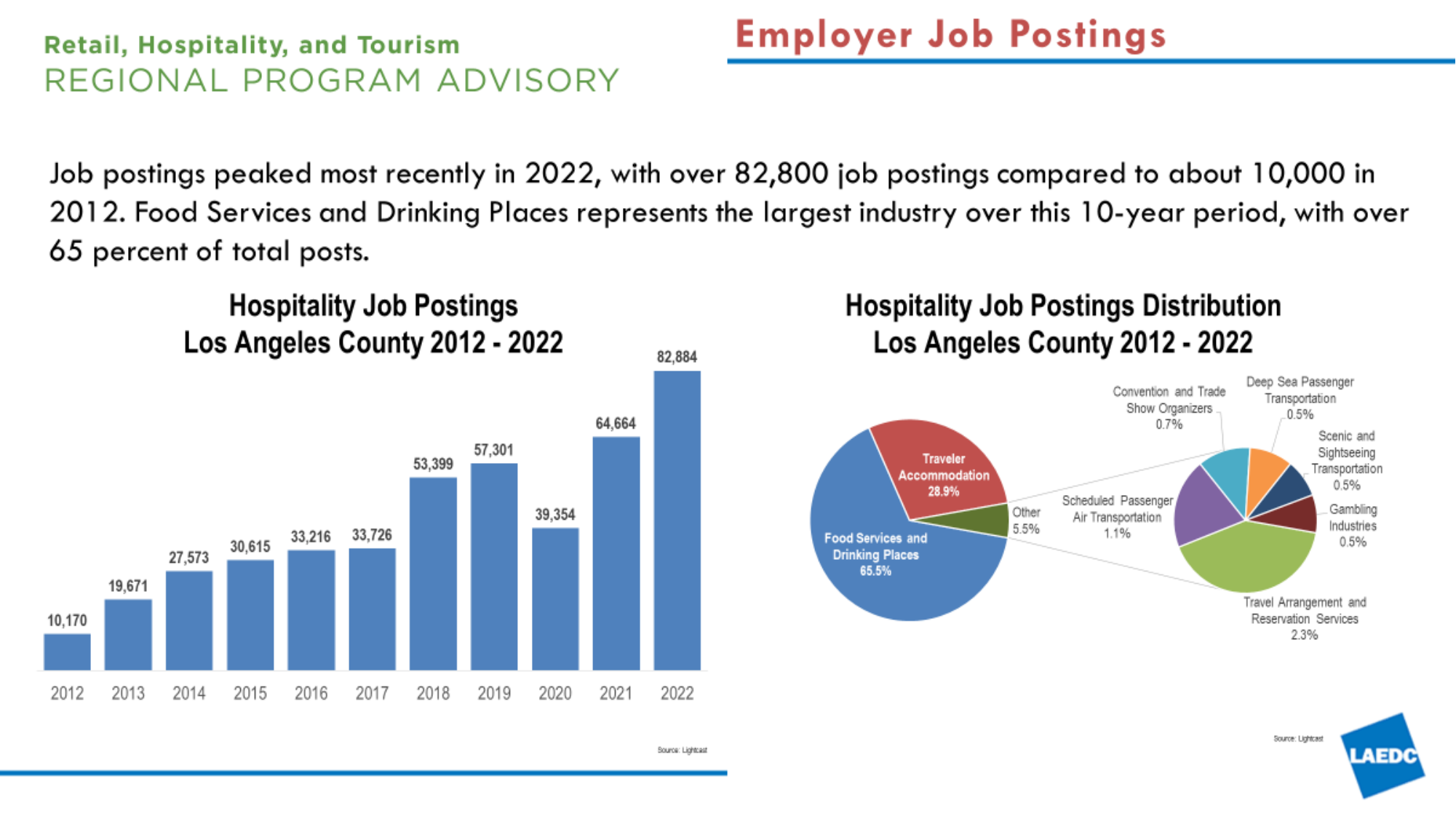
In the 'Hospitality Job Postings Distribution Los Angeles County 2012 - 2022' pie chart, what share does Traveler Accommodation have? 28.9% In the 'Hospitality Job Postings Los Angeles County 2012 - 2022' bar chart, what is the value for 2018? 53,399 In the 'Hospitality Job Postings Distribution Los Angeles County 2012 - 2022' pie chart, which category has the largest share? Food Services and Drinking Places What kind of chart is 'Hospitality Job Postings Distribution Los Angeles County 2012 - 2022'? Pie chart In the 'Hospitality Job Postings Los Angeles County 2012 - 2022' bar chart, what is the difference between the 2022 and 2021 values? 18,220 In the 'Hospitality Job Postings Los Angeles County 2012 - 2022' bar chart, which year has the lowest number of job postings? 2012 In the 'Hospitality Job Postings Distribution Los Angeles County 2012 - 2022' pie chart, what share does Travel Arrangement and Reservation Services have? 2.3% In the 'Hospitality Job Postings Los Angeles County 2012 - 2022' bar chart, which is larger, the value for 2019 or the value for 2020? 2019 In the 'Hospitality Job Postings Los Angeles County 2012 - 2022' bar chart, do the values rise or fall from 2019 to 2020? Fall In the 'Hospitality Job Postings Los Angeles County 2012 - 2022' bar chart, which year has the highest number of job postings? 2022 How many years are shown in the 'Hospitality Job Postings Los Angeles County 2012 - 2022' bar chart? 11 What kind of chart is 'Hospitality Job Postings Los Angeles County 2012 - 2022'? Bar chart